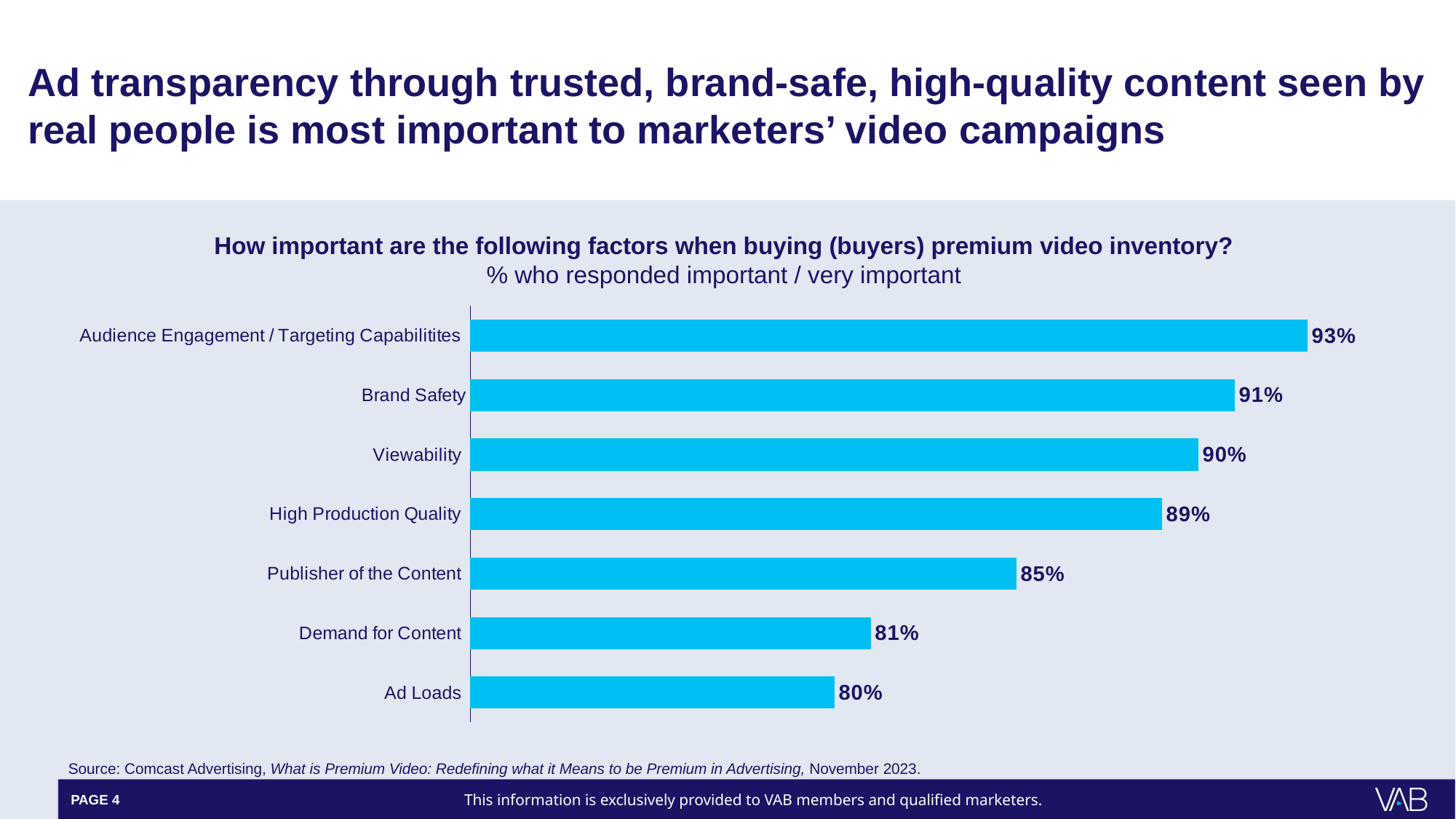
What is the difference in percentage points between Audience Engagement / Targeting Capabilitites and Ad Loads? 13 percentage points What is the title of the chart? How important are the following factors when buying (buyers) premium video inventory? What is the value shown for Publisher of the Content? 85% What is the difference between Viewability and Demand for Content? 9 percentage points Which factor has the lowest percentage? Ad Loads What is the value shown for Ad Loads? 80% Do the values increase or decrease going from the top bar to the bottom bar? Decrease Which factor has the highest percentage of buyers rating it important / very important? Audience Engagement / Targeting Capabilitites Which has a higher value, High Production Quality or Publisher of the Content? High Production Quality What type of chart is shown on the slide? Bar chart What percentage of buyers rated Brand Safety as important / very important? 91% How many factors are shown in the chart? 7